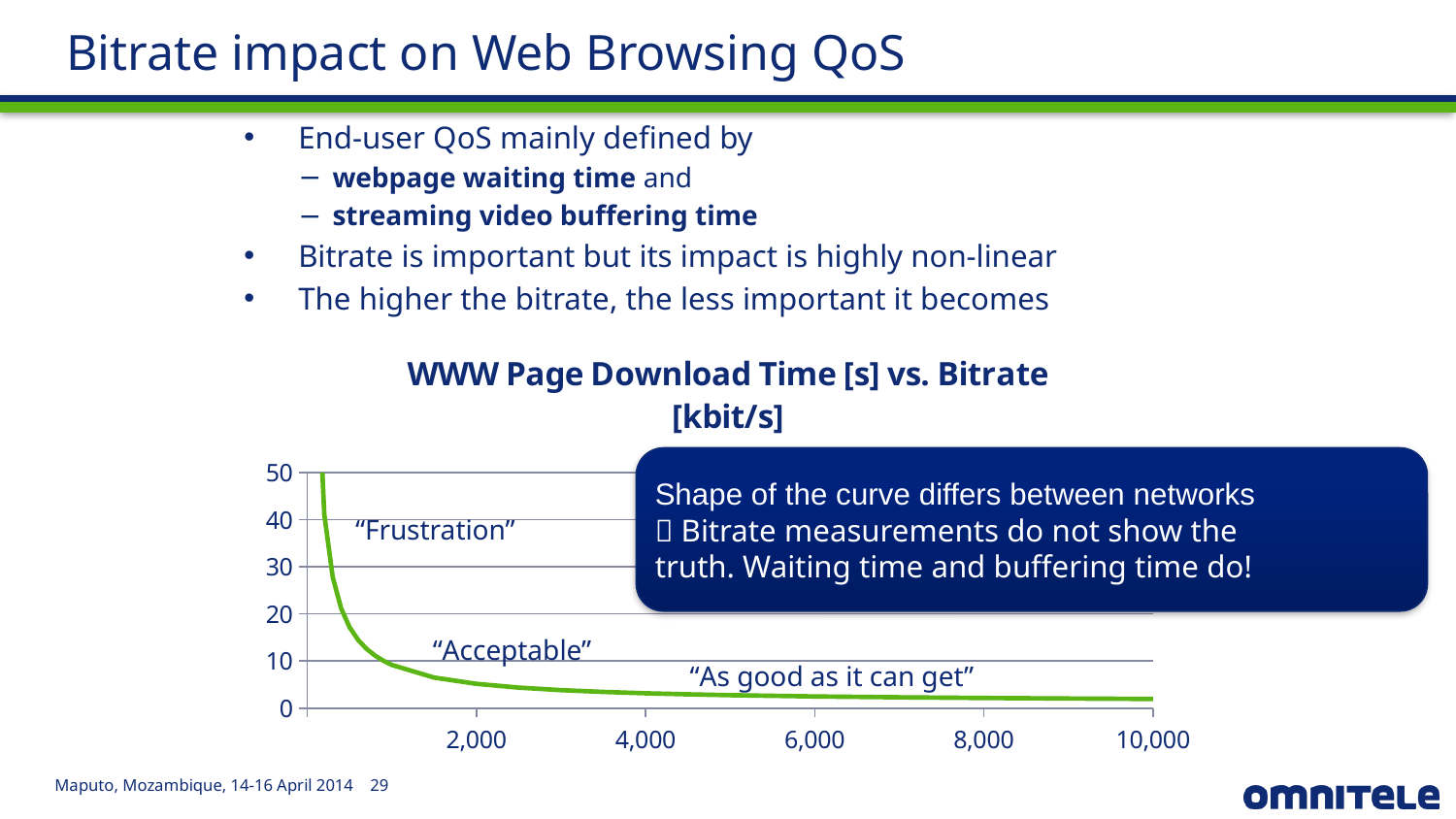
Is the download time at a bitrate of 2,000 kbit/s greater or less than 10 seconds? less How many lines are plotted on the chart? 1 What label is placed on the chart near the steep, high-download-time part of the curve? "Frustration" Does the download time rise or fall as bitrate increases along the x axis? fall Which is larger, the download time at 2,000 kbit/s or at 8,000 kbit/s? 2,000 kbit/s What is the title of the chart? WWW Page Download Time [s] vs. Bitrate [kbit/s] Is the download time at a bitrate of 10,000 kbit/s greater or less than 10 seconds? less What is the highest value shown on the y axis of the chart? 50 What kind of chart is shown on the slide? line chart Is the download time at a bitrate of 6,000 kbit/s greater or less than 20 seconds? less